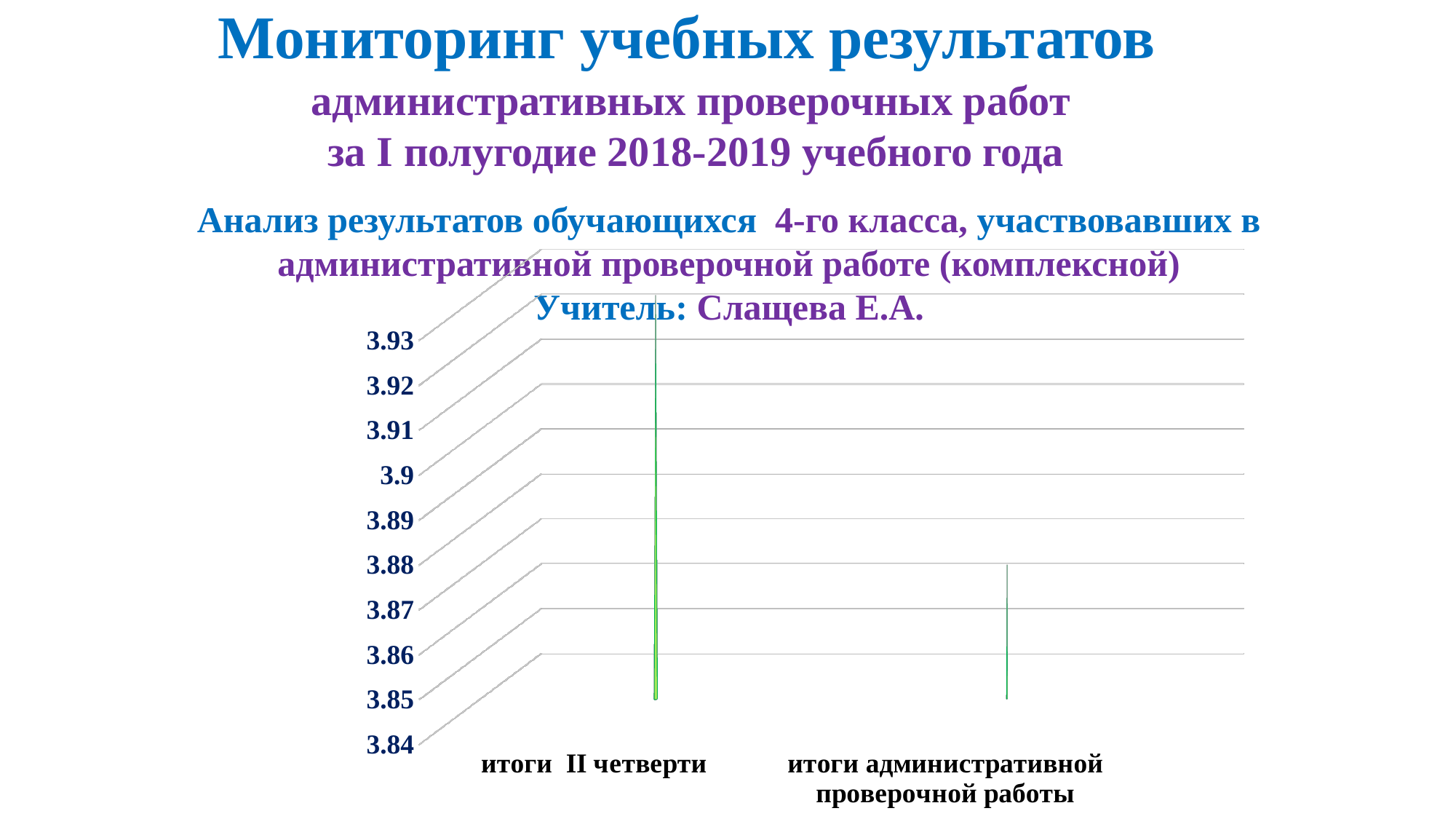
How many categories are shown on the x axis of the chart? 2 Which category has the lowest value in the chart? итоги административной проверочной работы Is the value for 'итоги II четверти' greater or less than 3.9? greater Which teacher is named in the chart heading on the slide? Слащева Е.А. What kind of chart is shown on the slide? bar chart Which is larger: the value for 'итоги II четверти' or the value for 'итоги административной проверочной работы'? итоги II четверти Is the value for 'итоги административной проверочной работы' greater or less than 3.85? greater What is the lowest value labelled on the vertical axis of the chart? 3.84 Which category has the highest value in the chart? итоги II четверти Is the value for 'итоги административной проверочной работы' greater or less than 3.9? less Do the values rise or fall from 'итоги II четверти' to 'итоги административной проверочной работы'? fall